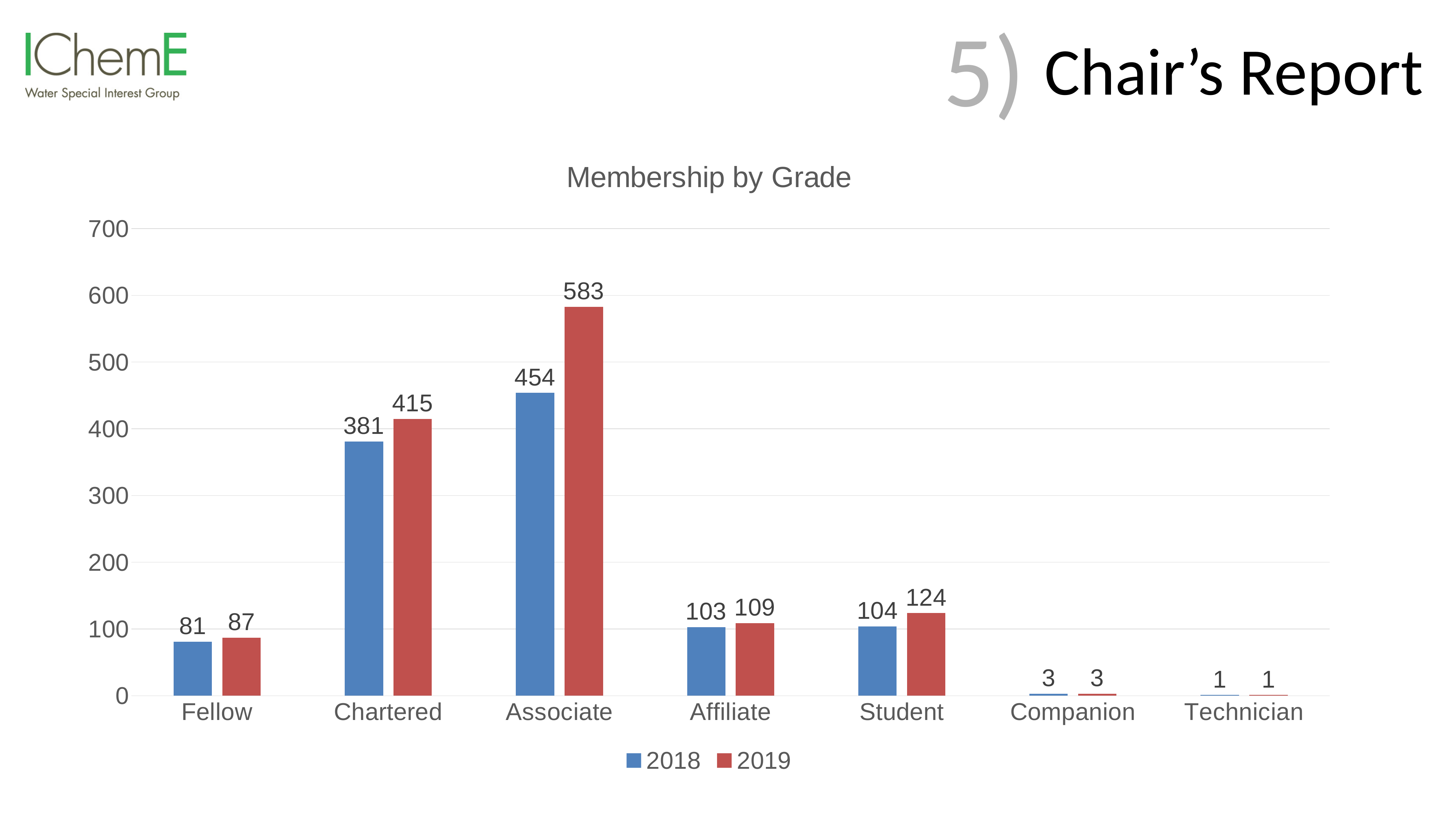
How many series does the legend list? 2 Which grade has the highest 2019 value? Associate Which grade has the lowest 2018 value? Technician Which is larger, the 2018 value for Affiliate or the 2018 value for Student? Student What is the difference between the 2019 and 2018 values for Chartered? 34 What is the 2018 value for Chartered? 381 What kind of chart is shown? Bar chart What is the difference between the 2019 and 2018 values for Associate? 129 What is the 2019 value for Associate? 583 How many grade categories are shown on the x axis? 7 What is the 2019 value for Student? 124 What is the title of the chart? Membership by Grade